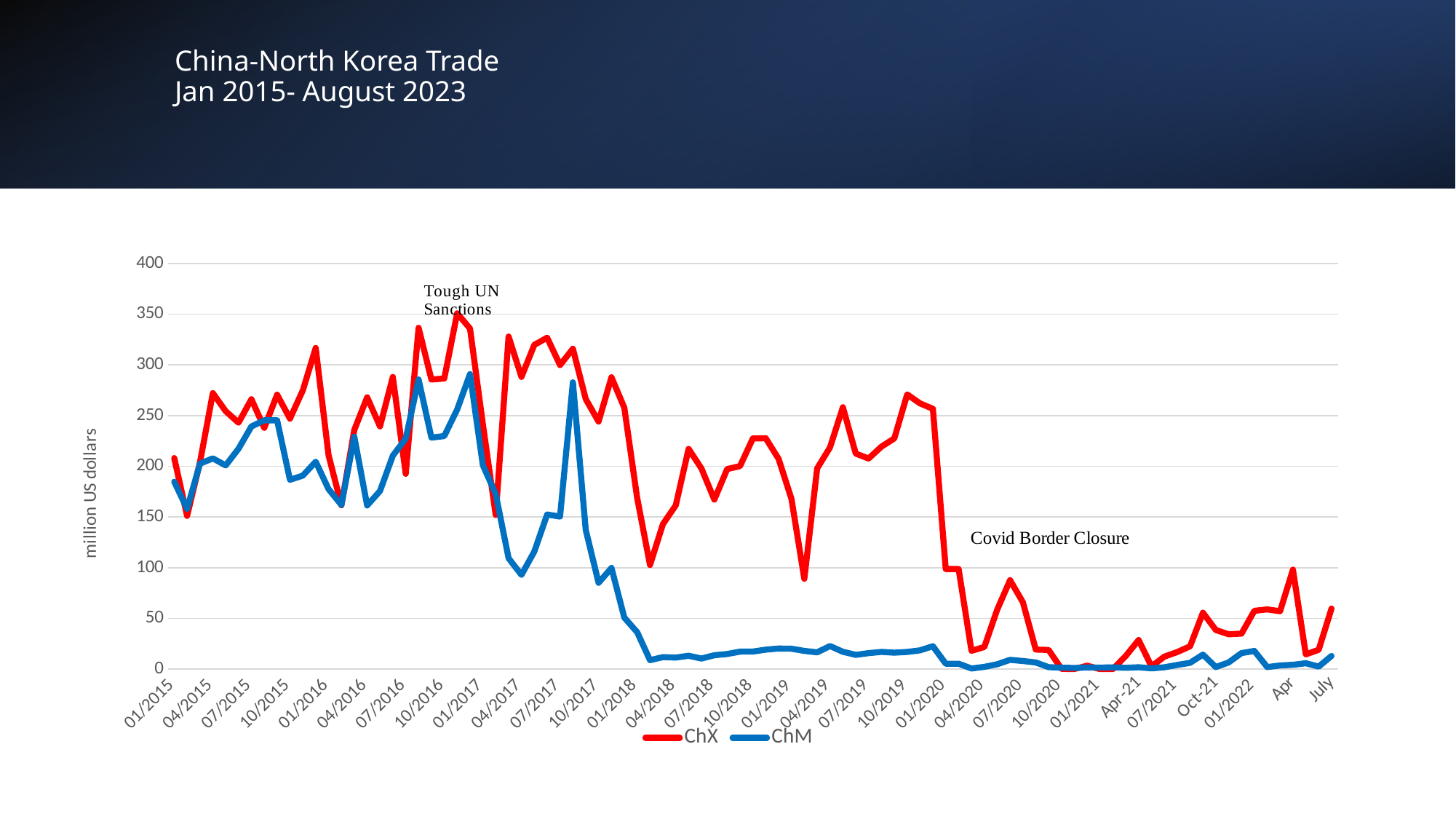
Is the value of ChM at 01/2017 greater or less than 250? less What kind of chart is shown on the slide? line chart Does the ChM series rise or fall between 10/2017 and 04/2018? fall Which series reaches the higher peak value over the whole period? ChX Is the value of ChX at 04/2020 greater or less than 50? less What are the names of the two series in the legend? ChX and ChM Is the value of ChM at 04/2018 greater or less than 50? less How many series does the legend list? 2 What is the label on the vertical axis? million US dollars At 10/2019, which series has the larger value, ChX or ChM? ChX